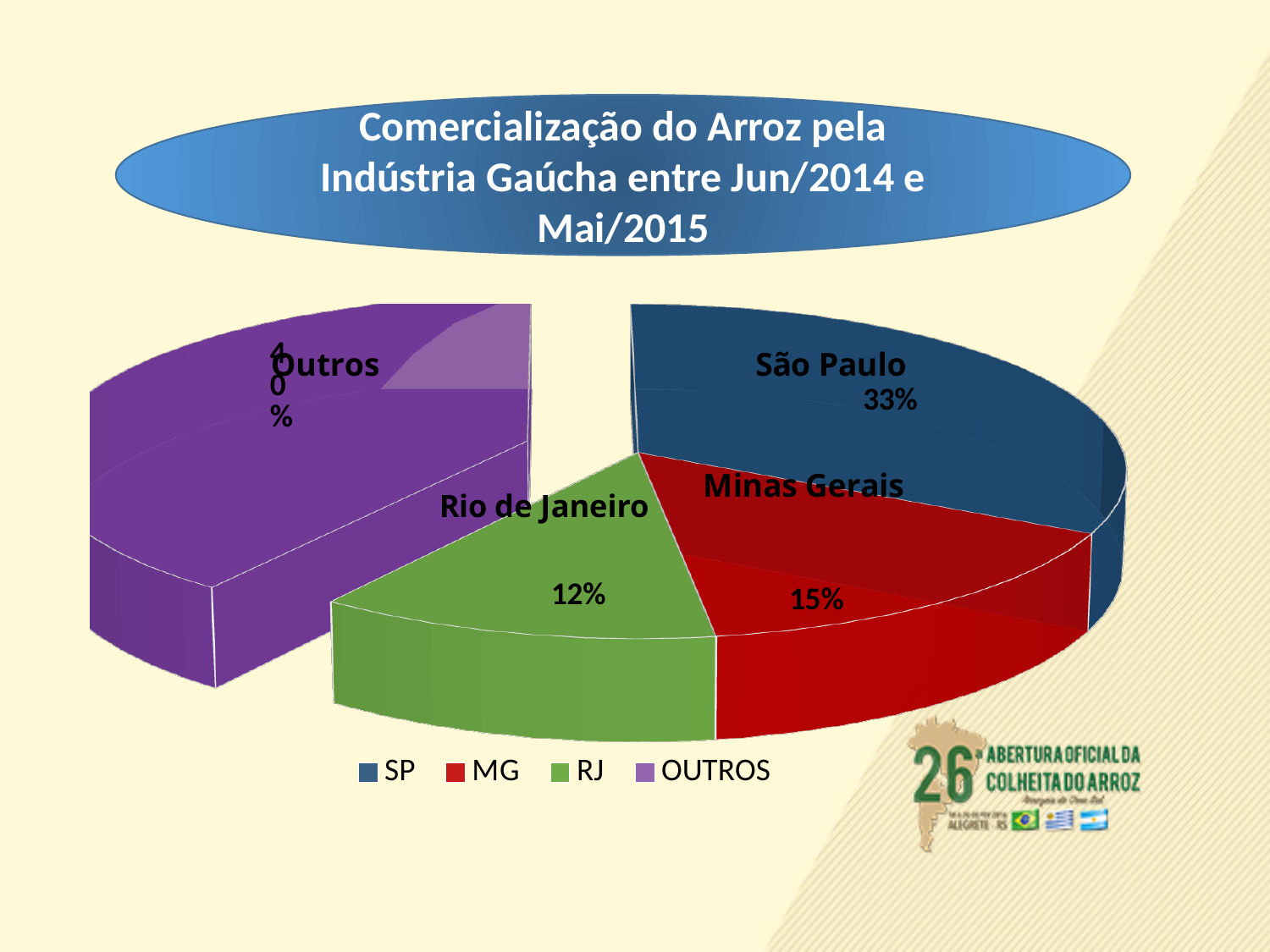
What is the value shown for Rio de Janeiro? 12% How many entries does the legend list? 4 What kind of chart is shown on the slide? pie chart How many slices does the pie chart have? 4 How many percentage points larger is São Paulo's share than Minas Gerais's share? 18% What colour is the São Paulo slice? blue Which has the larger share, Minas Gerais or Rio de Janeiro? Minas Gerais What is the value shown for Outros? 40% Which slice of the pie is the largest? Outros What percentage of the pie does São Paulo account for? 33% What is the value shown for Minas Gerais? 15% Which slice of the pie is the smallest? Rio de Janeiro